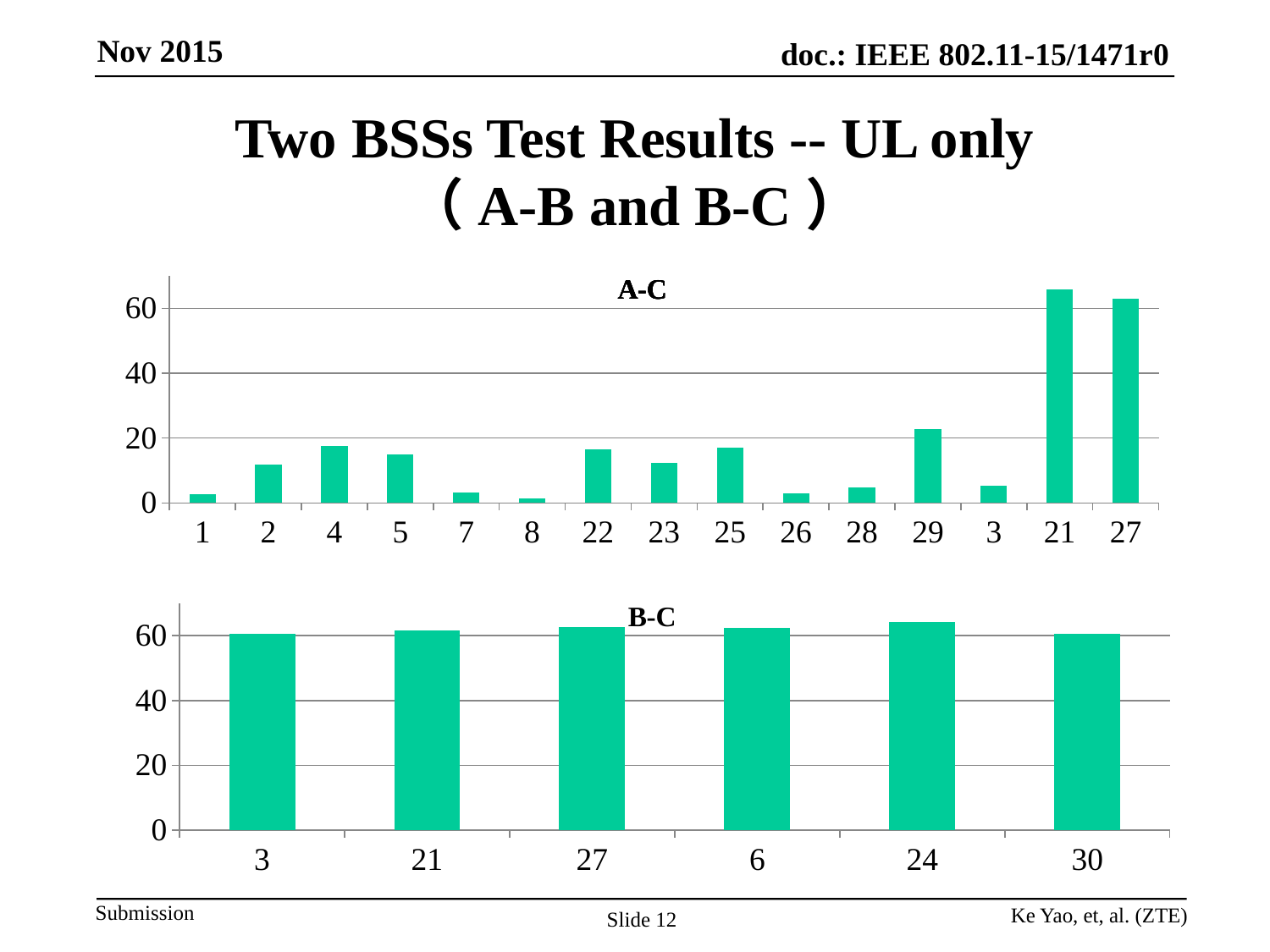
How many categories are shown on the x axis of the A-C chart? 15 What kind of chart is the A-C chart at the top of the slide? bar chart What is the title of the bottom chart on the slide? B-C In the A-C chart, is the value for category 29 greater or less than 20? greater In the B-C chart, is the value for category 3 greater or less than 40? greater In the A-C chart, which is larger, the value for category 29 or the value for category 5? 29 In the A-C chart, which is larger, the value for category 4 or the value for category 2? 4 How many categories are shown on the x axis of the B-C chart? 6 In the A-C chart, is the value for category 21 greater or less than 60? greater In the A-C chart, which category has the highest bar? 21